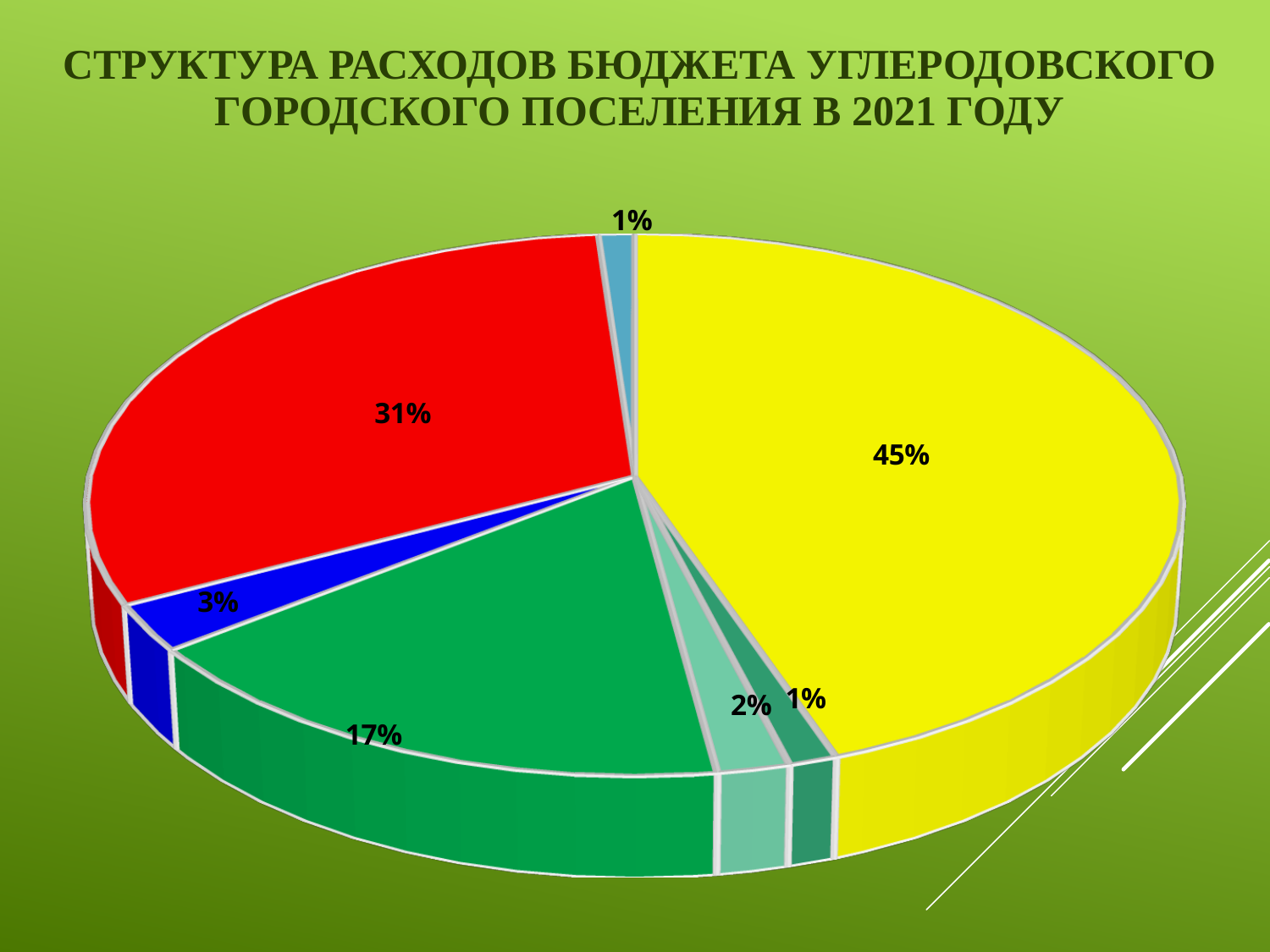
What share does the blue slice represent? 3% What share does the red slice represent? 31% What is the title of the chart? СТРУКТУРА РАСХОДОВ БЮДЖЕТА УГЛЕРОДОВСКОГО ГОРОДСКОГО ПОСЕЛЕНИЯ В 2021 ГОДУ What share does the light green slice next to the 17% slice represent? 2% How many slices are labelled 1%? 2 Which is larger, the red slice or the green slice? the red slice Which slice is the largest in the pie chart? the yellow slice (45%) What share does the yellow slice represent? 45% How many slices does the pie chart have? 7 What is the difference in percentage points between the yellow slice and the red slice? 14 What share does the large green slice represent? 17% What kind of chart is shown on the slide? pie chart